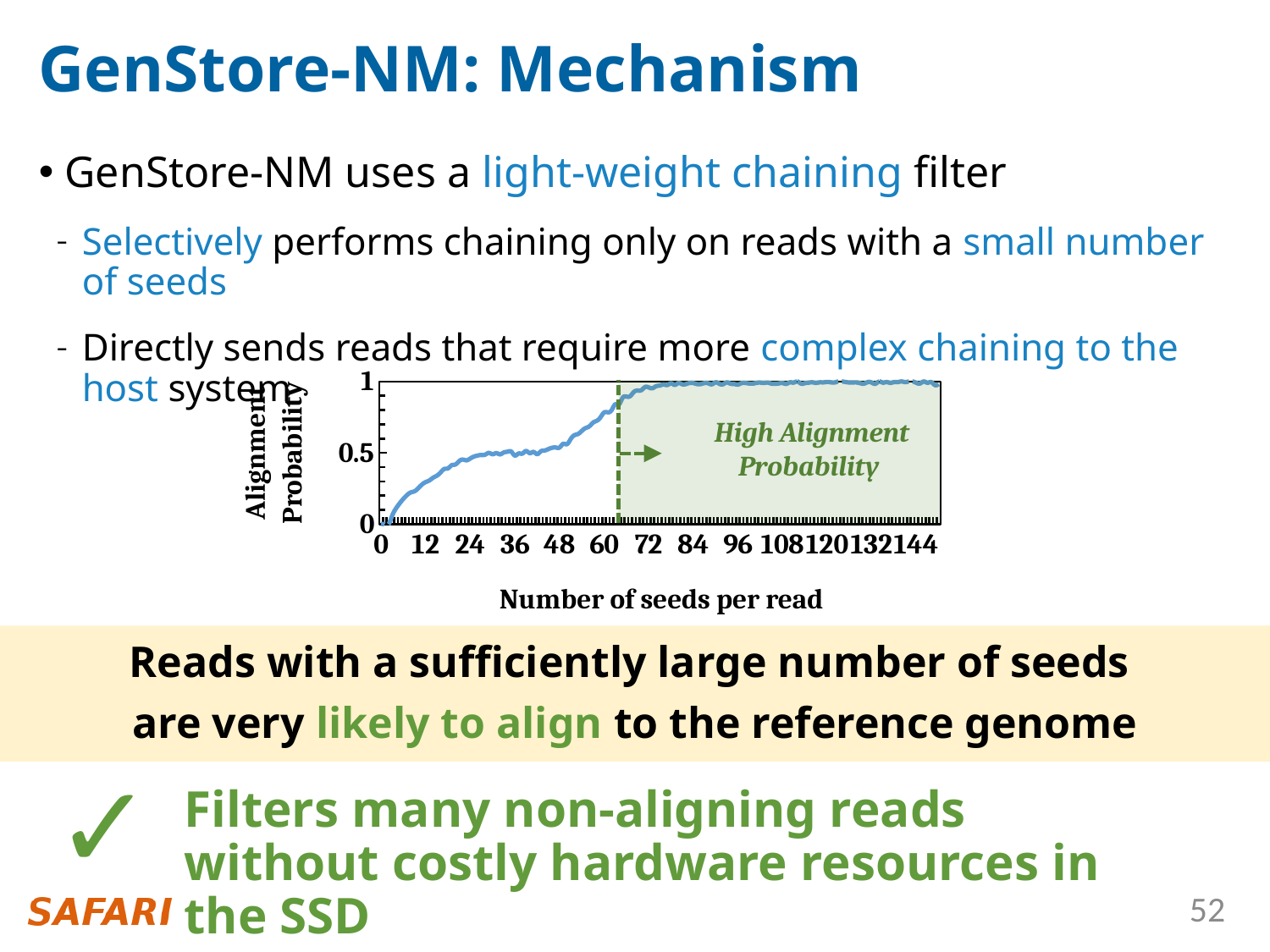
Is the alignment probability at 144 seeds per read greater or less than 0.5? greater Which has the higher alignment probability: 24 seeds per read or 96 seeds per read? 96 seeds per read What is the label of the y axis of the chart? Alignment Probability Does the alignment probability rise or fall as the number of seeds per read increases? rise Is the alignment probability at 12 seeds per read greater or less than 0.5? less What is the label of the x axis of the chart? Number of seeds per read Is the alignment probability at 72 seeds per read greater or less than 0.5? greater What kind of chart is shown on the slide? line chart What is the highest tick value shown on the x axis of the chart? 144